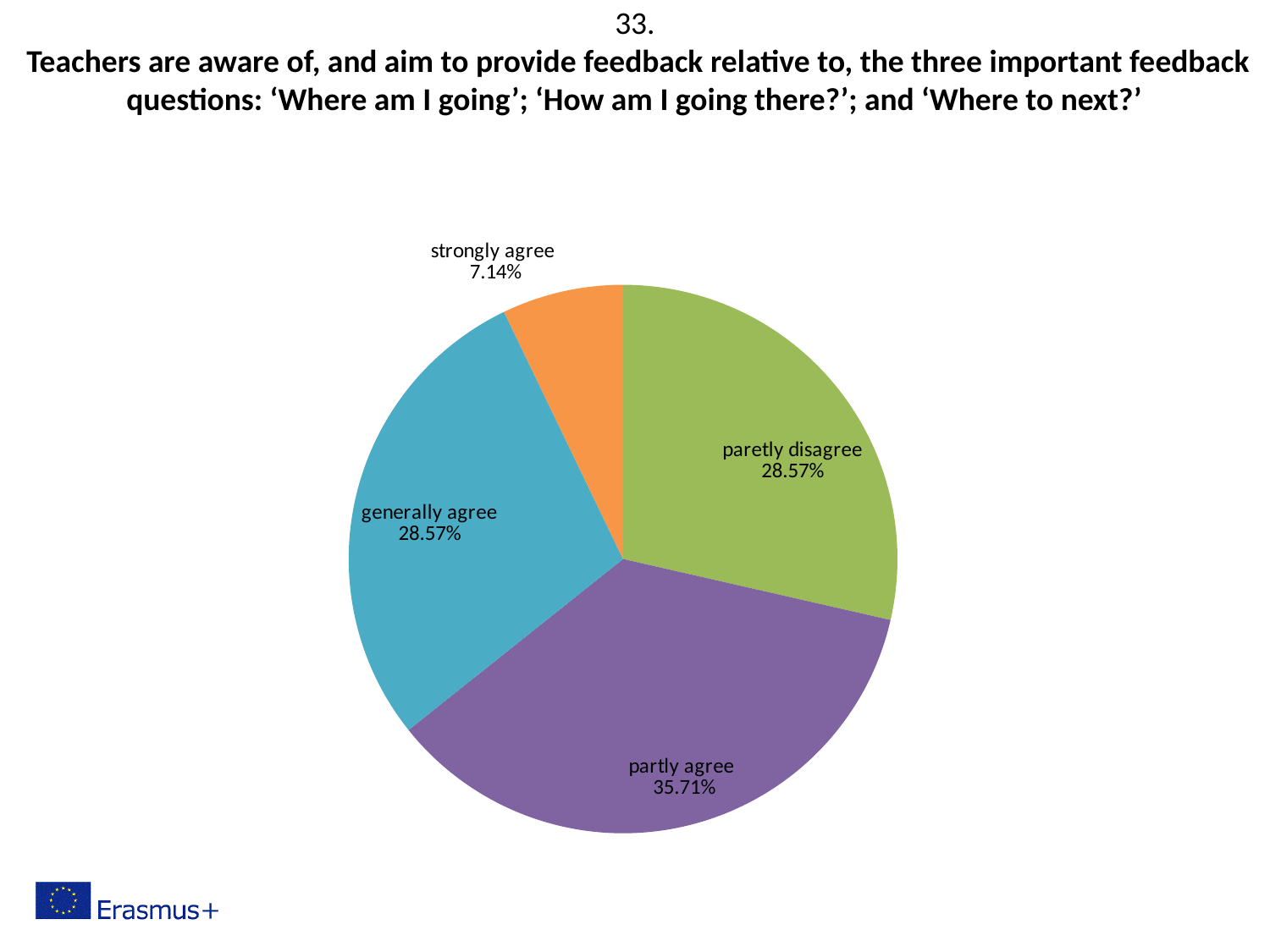
What is the difference between the 'partly agree' share and the 'strongly agree' share? 28.57% What kind of chart is shown on the slide? pie chart What share of the pie is labelled 'paretly disagree'? 28.57% How many slices does the pie chart have? 4 Which is larger, the 'partly agree' slice or the 'paretly disagree' slice? partly agree Which slice of the pie is the smallest? strongly agree What share of the pie is labelled 'partly agree'? 35.71% What share of the pie is labelled 'strongly agree'? 7.14% What colour is the 'partly agree' slice? purple Which slice of the pie is the largest? partly agree What is the difference between the 'partly agree' share and the 'generally agree' share? 7.14%